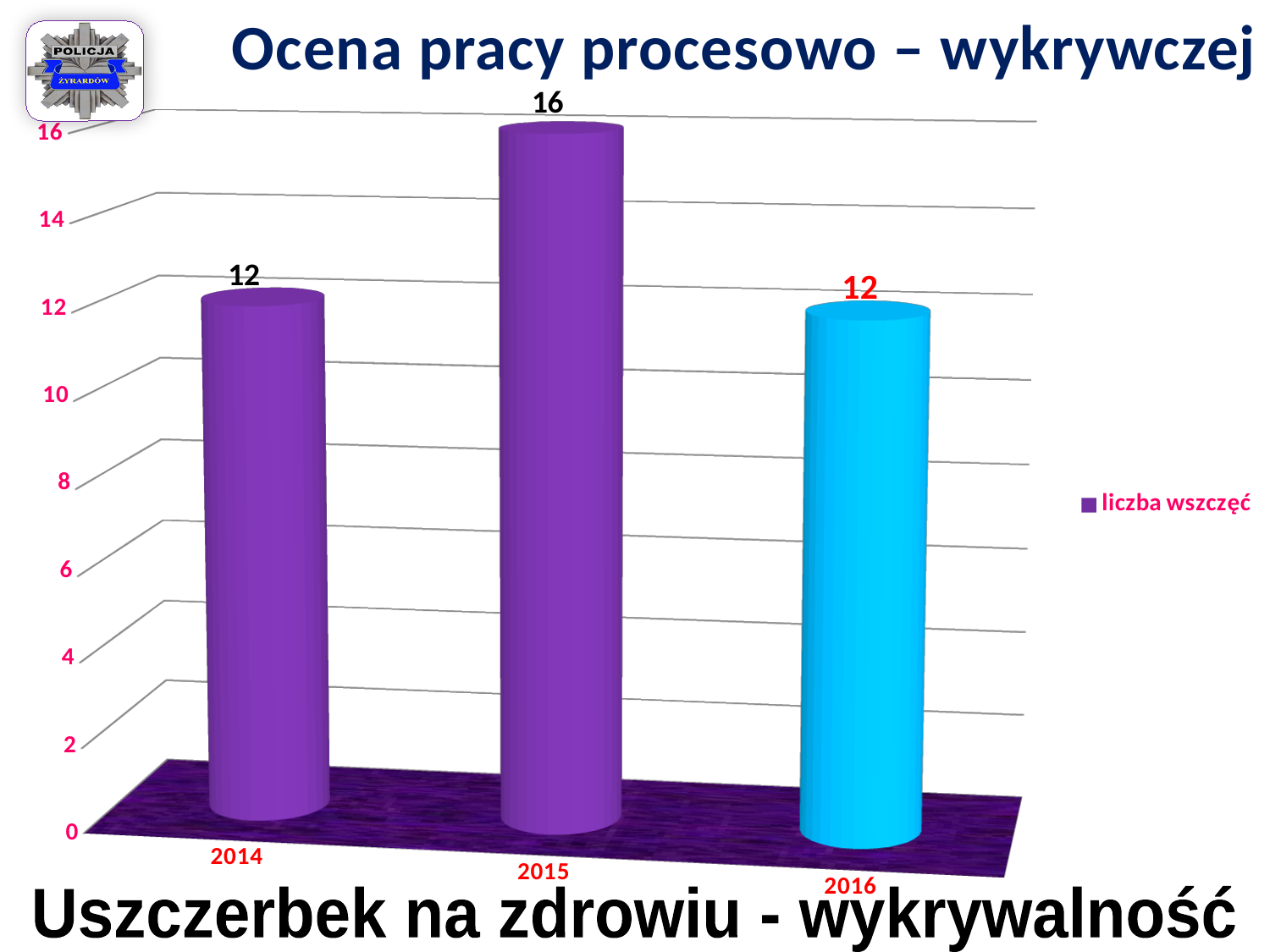
What is the difference between the values for 2015 and 2014? 4 Which is larger, the value for 2015 or the value for 2016? 2015 What is the value for 2016? 12 How many years are shown on the x axis? 3 What kind of chart is shown on the slide? bar chart Is the value for 2015 greater or less than 14? greater What is the series name shown in the legend? liczba wszczęć What is the value for 2014? 12 How many series does the legend list? 1 Which year has the highest value? 2015 What is the value for 2015? 16 Is the value for 2014 greater or less than 14? less